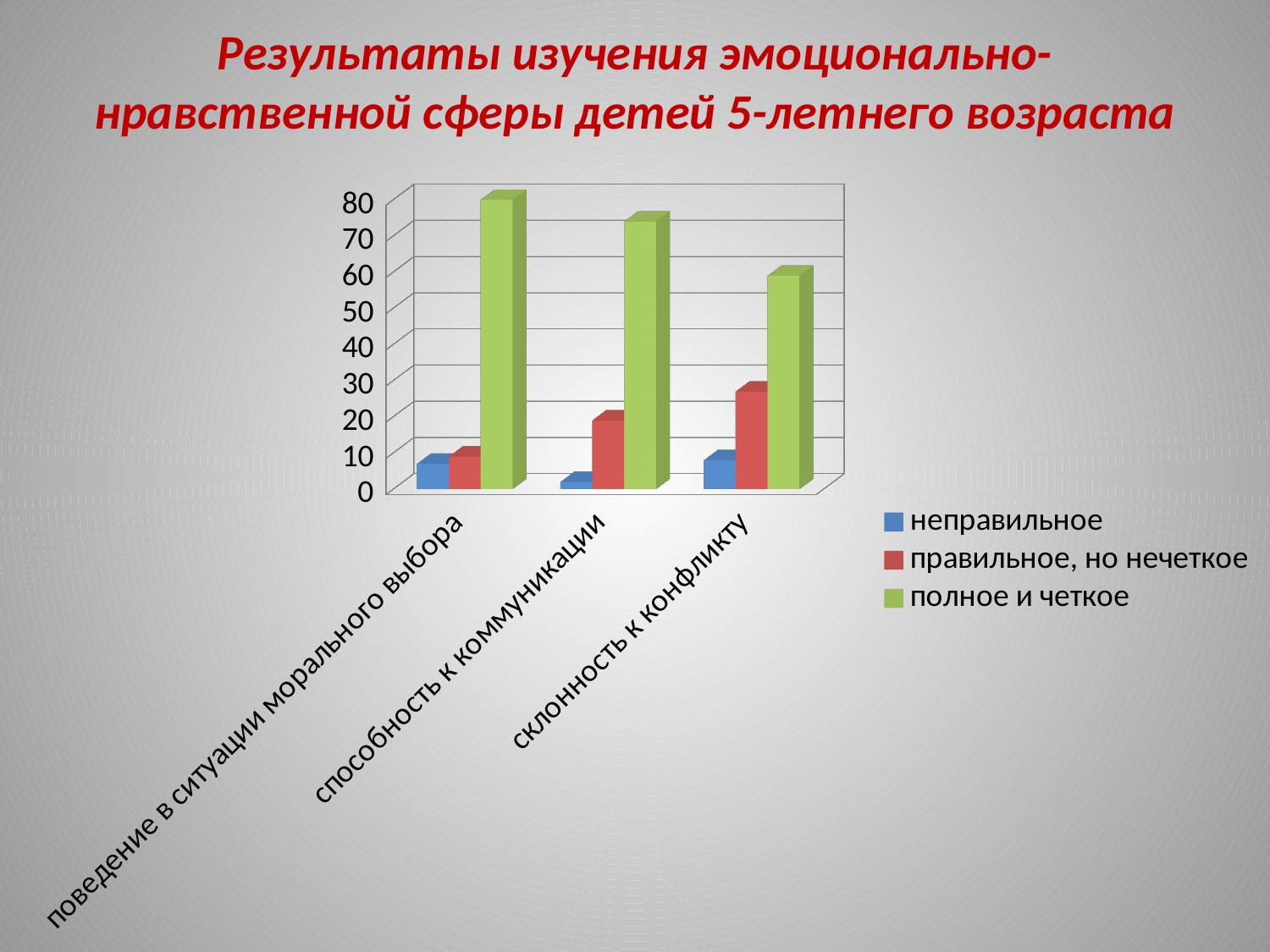
Is the value of "полное и четкое" for "поведение в ситуации морального выбора" greater or less than 70? greater Which category has the lowest value for the series "неправильное"? способность к коммуникации Is the value of "неправильное" for "способность к коммуникации" greater or less than 10? less For "склонность к конфликту", which is larger: "правильное, но нечеткое" or "неправильное"? правильное, но нечеткое What kind of chart is shown on the slide? bar chart Is the value of "полное и четкое" for "склонность к конфликту" greater or less than 70? less Which colour represents the series "полное и четкое" in the chart? green Which category has the highest value for the series "правильное, но нечеткое"? склонность к конфликту How many categories are shown on the x axis of the chart? 3 Which category has the highest value for the series "полное и четкое"? поведение в ситуации морального выбора How many series does the chart's legend list? 3 Do the values of the series "полное и четкое" rise or fall from left to right across the categories? fall